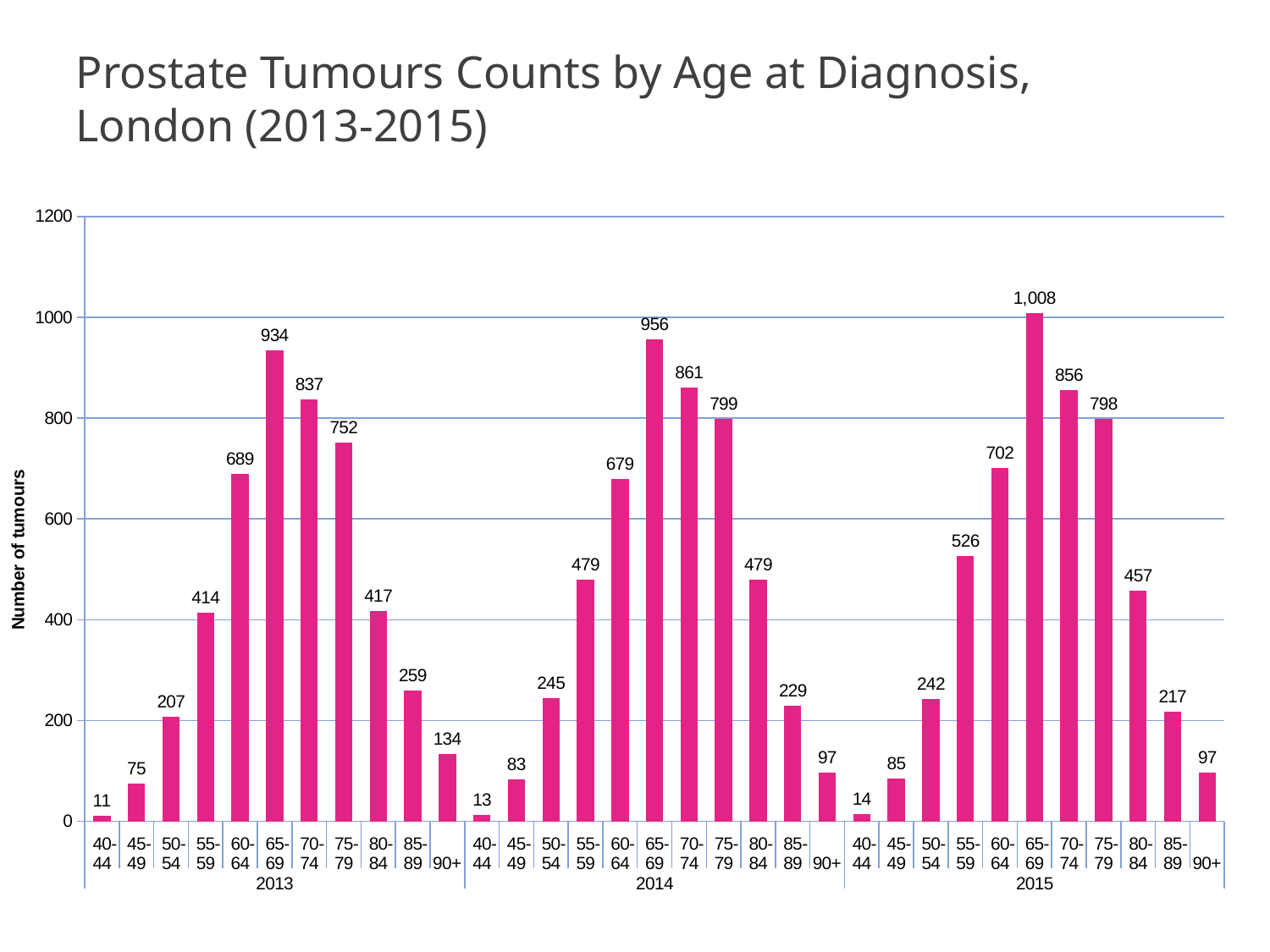
What is the difference between the 65-69 counts in 2014 and 2013? 22 What is the number of tumours for the 80-84 age group in 2014? 479 Which year and age group has the lowest number of tumours on the chart? 40-44 in 2013 What is the label of the vertical axis? Number of tumours How many age-group bars are shown for each year? 11 What is the number of tumours for the 65-69 age group in 2015? 1,008 Which year and age group has the highest number of tumours on the chart? 65-69 in 2015 Which is larger, the 70-74 count in 2013 or the 70-74 count in 2015? 70-74 in 2015 What is the number of tumours for the 40-44 age group in 2013? 11 Within 2014, do the values rise or fall from the 40-44 age group to the 65-69 age group? Rise Is the value for the 55-59 age group in 2015 greater or less than 400? greater What kind of chart is shown on the slide? Bar chart